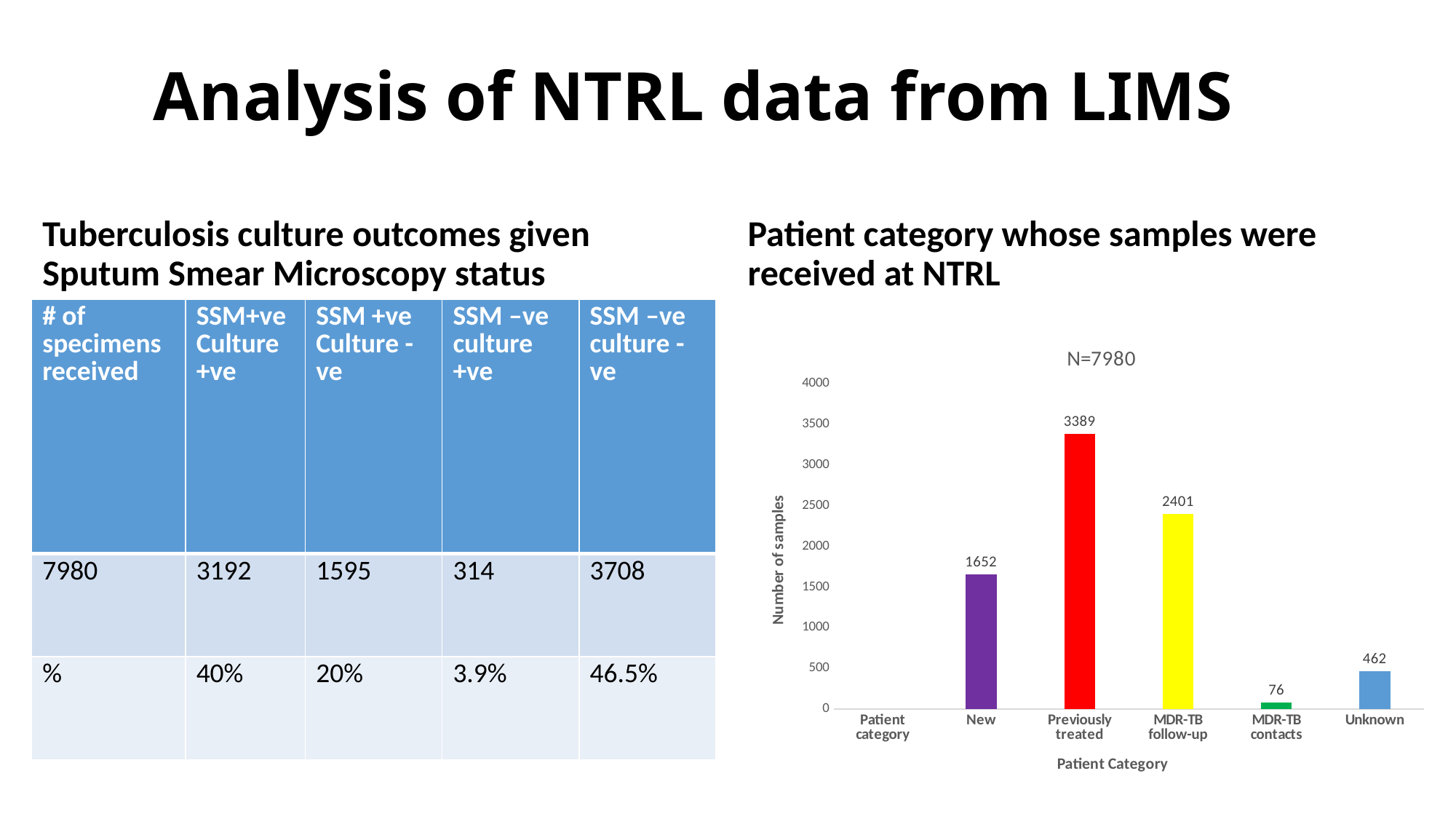
In the bar chart, what is the difference in number of samples between Previously treated and New? 1737 In the bar chart, what is the number of samples for the New patient category? 1652 How many bars are plotted in the bar chart? 5 What type of chart is shown on the right side of the slide? bar chart In the bar chart, which patient category has the lowest number of samples? MDR-TB contacts In the bar chart, which has more samples: MDR-TB follow-up or Unknown? MDR-TB follow-up In the bar chart, what is the number of samples for MDR-TB follow-up? 2401 What is the title shown above the bar chart? N=7980 In the bar chart, what is the number of samples for Previously treated patients? 3389 In the bar chart, what is the number of samples for the Unknown category? 462 In the bar chart, which patient category has the highest number of samples? Previously treated In the bar chart, what is the number of samples for MDR-TB contacts? 76